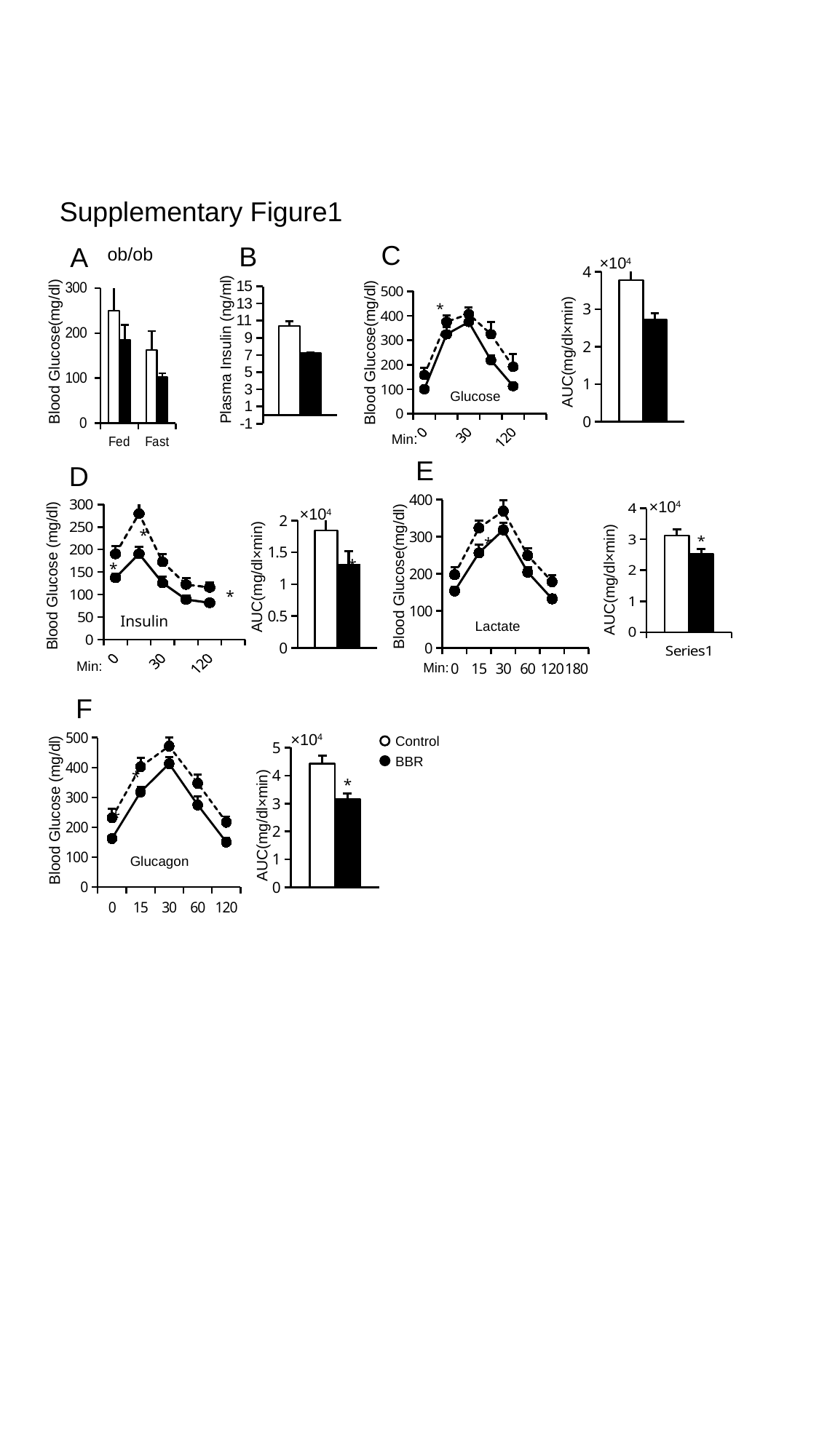
In panel A (ob/ob), is the value of the white bar for Fed greater or less than 200? greater In panel A (ob/ob), what kind of chart is shown? bar chart In the AUC bar chart of panel C, is the value of the white bar greater or less than 3? greater In the AUC bar chart of panel E, is the value of the black bar greater or less than 3? less In panel A (ob/ob), which category has the taller white bar, Fed or Fast? Fed In panel B (Plasma Insulin), which bar is taller, the white bar or the black bar? white bar What two series does the legend on the slide list? Control and BBR In the Glucagon line chart of panel F, how many time points are labelled on the x axis? 5